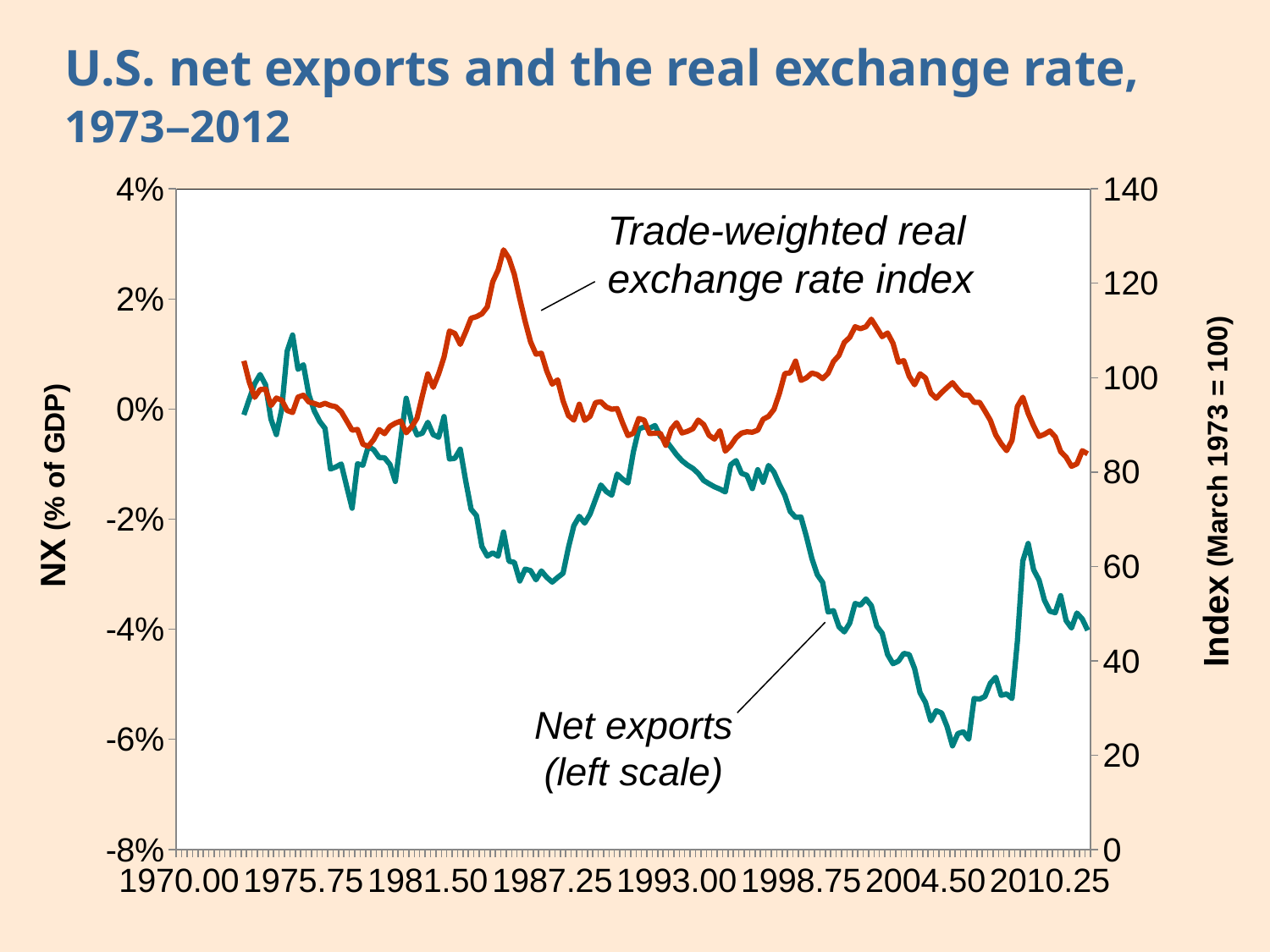
What is the maximum value shown on the right-hand axis? 140 Is the highest value of the trade-weighted real exchange rate index greater or less than 120? greater Is the lowest value of net exports (around 2006) greater or less than -4%? less Overall, do net exports rise or fall from 1973 to 2012? fall Does the trade-weighted real exchange rate index rise or fall between 1980 and 1985? rise Is the value of net exports at the start of the series (1973) greater or less than -2%? greater What is the title of the chart? U.S. net exports and the real exchange rate, 1973–2012 Which series is plotted on the left scale? Net exports What kind of chart is shown on the slide? line chart How many data series are plotted on the chart? 2